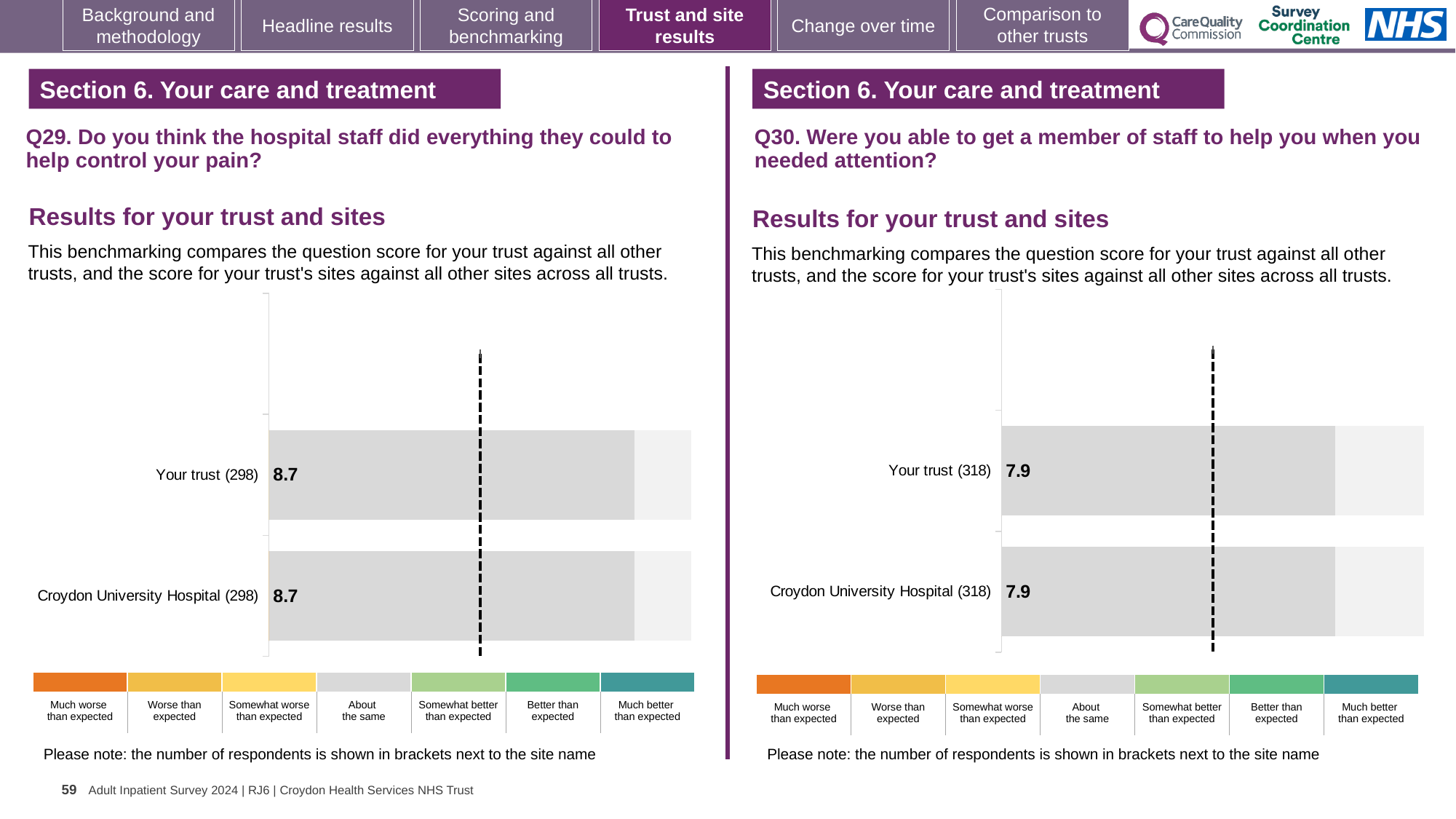
On the Q30 chart (right), what is the score for Your trust? 7.9 How many bars are plotted on the Q30 chart (right)? 2 On the Q29 chart (left), how many respondents are shown in brackets next to Your trust? 298 How many bars are plotted on the Q29 chart (left)? 2 On the Q30 chart (right), how many respondents are shown in brackets next to Croydon University Hospital? 318 On the Q29 chart (left), what is the score for Your trust? 8.7 On the Q29 chart (left), what is the difference between the score for Your trust and the score for Croydon University Hospital? 0 On the Q30 chart (right), what is the score for Croydon University Hospital? 7.9 On the Q30 chart (right), what is the difference between the score for Your trust and the score for Croydon University Hospital? 0 Is the score for Your trust on the Q29 chart (left) larger or smaller than the score for Your trust on the Q30 chart (right)? Larger On the Q29 chart (left), what is the score for Croydon University Hospital? 8.7 What kind of chart is used for the Q29 results (left)? Bar chart